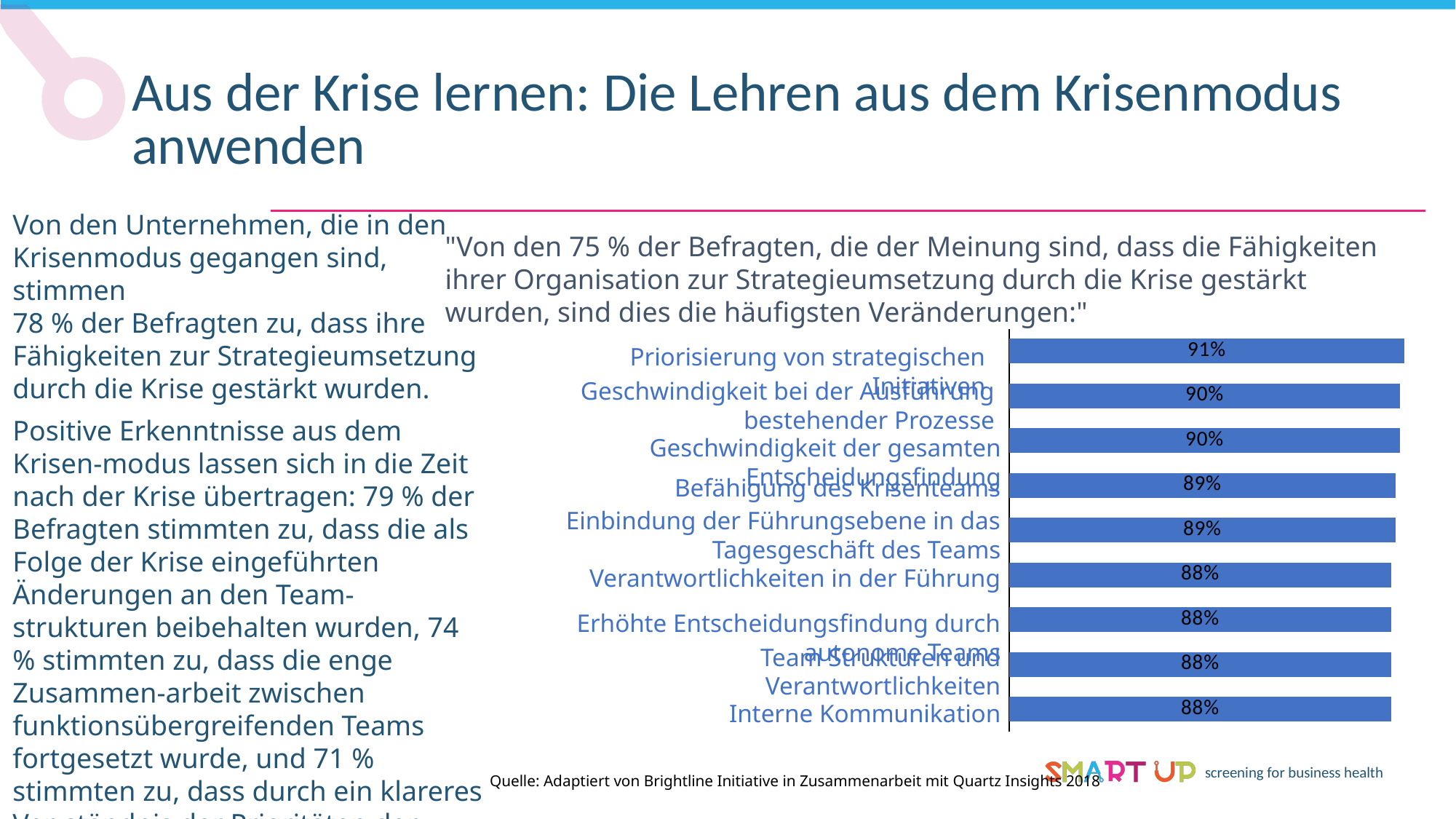
Which category has the highest value in the chart? Priorisierung von strategischen Initiativen Which is larger: the value for "Geschwindigkeit bei der Ausführung bestehender Prozesse" or the value for "Team-Strukturen und Verantwortlichkeiten"? Geschwindigkeit bei der Ausführung bestehender Prozesse What is the value for "Verantwortlichkeiten in der Führung"? 88% What is the value for "Geschwindigkeit der gesamten Entscheidungsfindung"? 90% Do the bar values increase or decrease from the top of the chart to the bottom? decrease What source is cited below the chart? Adaptiert von Brightline Initiative in Zusammenarbeit mit Quartz Insights 2018 What kind of chart is shown on the slide? bar chart What is the value for "Interne Kommunikation"? 88% How many categories (bars) does the chart show? 9 What is the value for "Befähigung des Krisenteams"? 89% What is the difference between the values for "Priorisierung von strategischen Initiativen" and "Interne Kommunikation"? 3 percentage points What is the value for "Priorisierung von strategischen Initiativen"? 91%